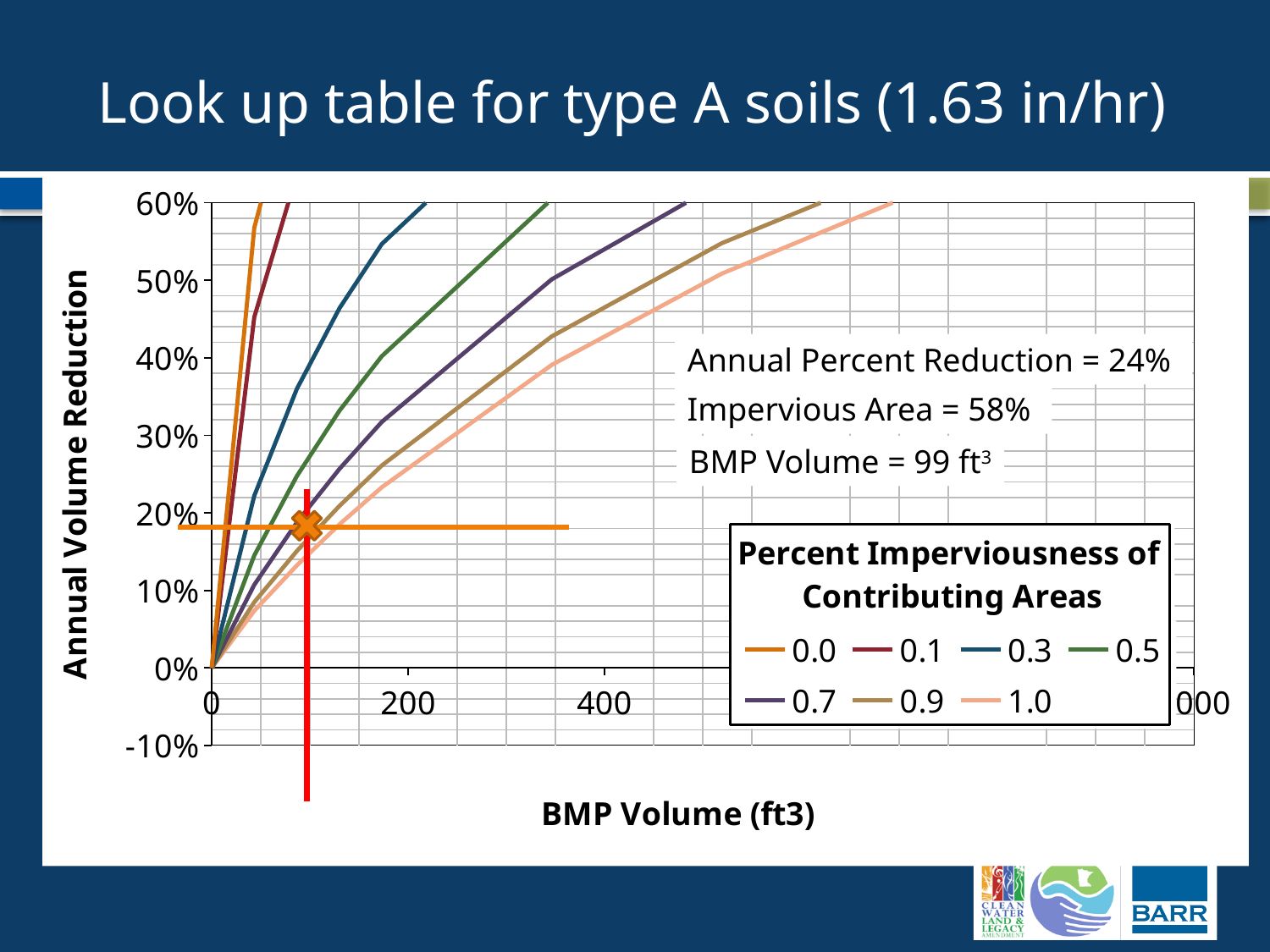
At a BMP volume of 400 ft3, is the annual volume reduction for the 0.7 series greater or less than 40%? greater Which series reaches 60% annual volume reduction at the smallest BMP volume? 0.0 Do the plotted lines rise or fall as BMP Volume increases? rise At a BMP volume of 200 ft3, which series has the higher annual volume reduction, 0.3 or 1.0? 0.3 At a BMP volume of 200 ft3, is the annual volume reduction for the 1.0 series greater or less than 40%? less What is the title of the legend? Percent Imperviousness of Contributing Areas At a BMP volume of 200 ft3, is the annual volume reduction for the 0.7 series greater or less than 30%? greater Which series reaches 60% annual volume reduction at the largest BMP volume? 1.0 What is the label of the x axis? BMP Volume (ft3) How many series does the legend list? 7 What kind of chart is shown on the slide? line chart